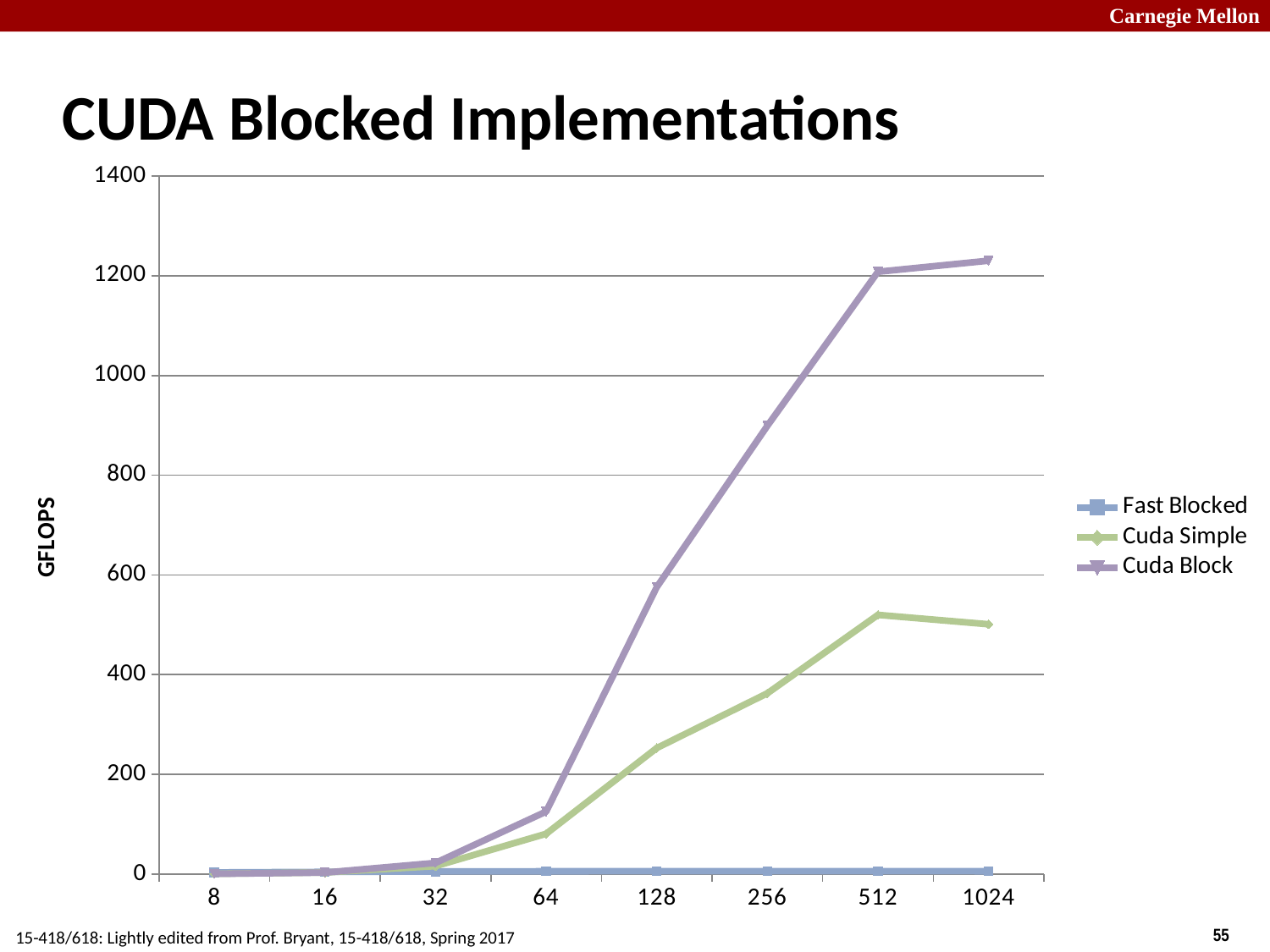
Is the Cuda Block value at 512 greater or less than 1000? greater Is the Cuda Simple value at 1024 greater or less than 600? less Is the Cuda Simple value at 128 greater or less than 400? less How many series does the legend list? 3 What kind of chart is shown on the slide? line chart What is the label on the y axis? GFLOPS Does the Cuda Block series generally rise or fall as the x-axis value increases from 8 to 1024? rise How many points are plotted along the x axis for each series? 8 Which series has the lowest GFLOPS values across the chart? Fast Blocked Which series reaches the highest GFLOPS value at 1024? Cuda Block At 512, which series is larger: Cuda Block or Cuda Simple? Cuda Block